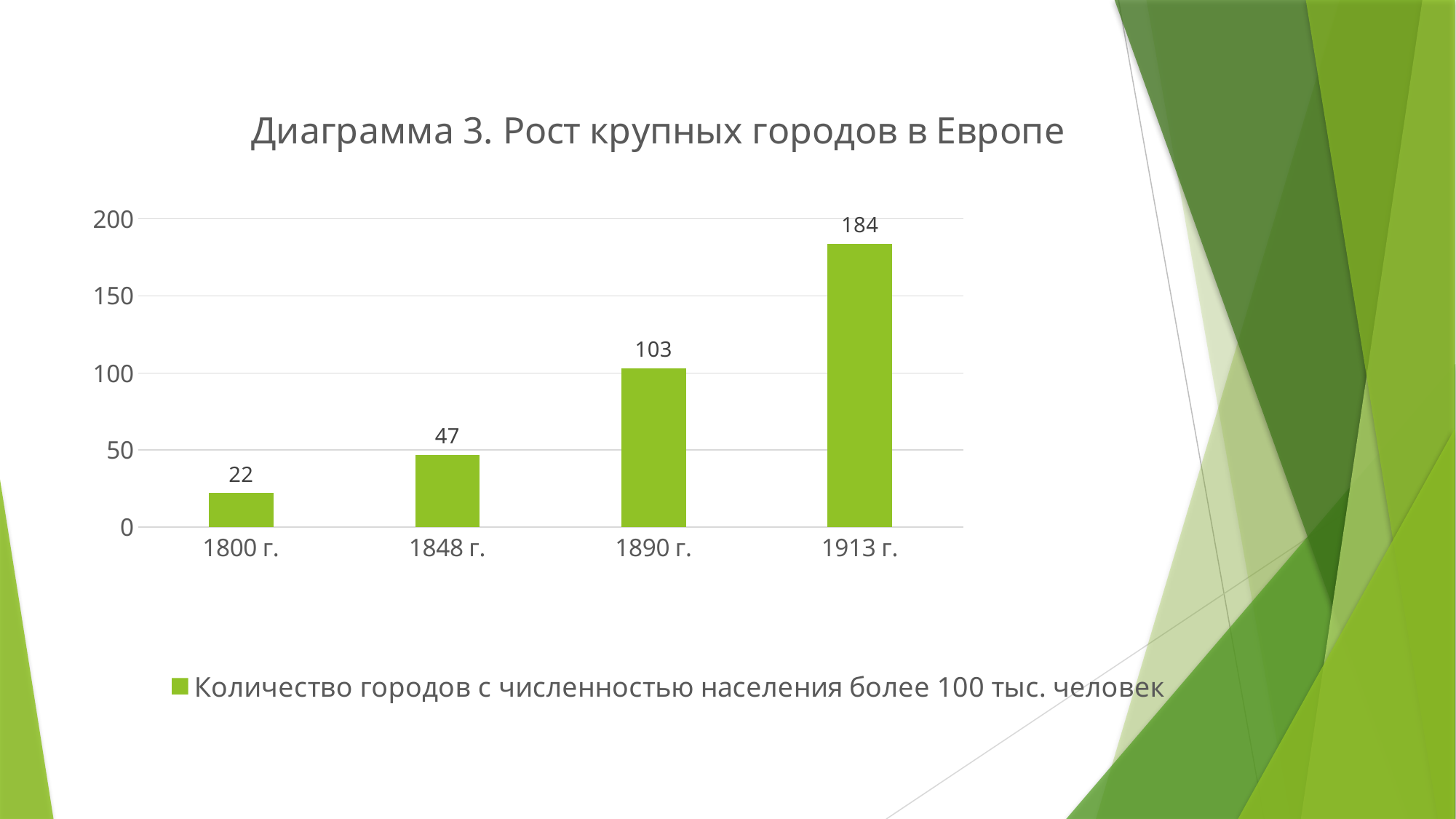
How many years are shown on the x axis? 4 What is the value for 1913 г.? 184 What kind of chart is this? bar chart What is the value for 1890 г.? 103 Which year has the lowest value? 1800 г. What is the value for 1800 г.? 22 What is the value for 1848 г.? 47 Which year has the highest value? 1913 г. What is the difference between the values for 1913 г. and 1890 г.? 81 Do the values rise or fall from 1800 г. to 1913 г.? rise Which is larger, the value for 1848 г. or the value for 1890 г.? 1890 г. What is the difference between the values for 1848 г. and 1800 г.? 25